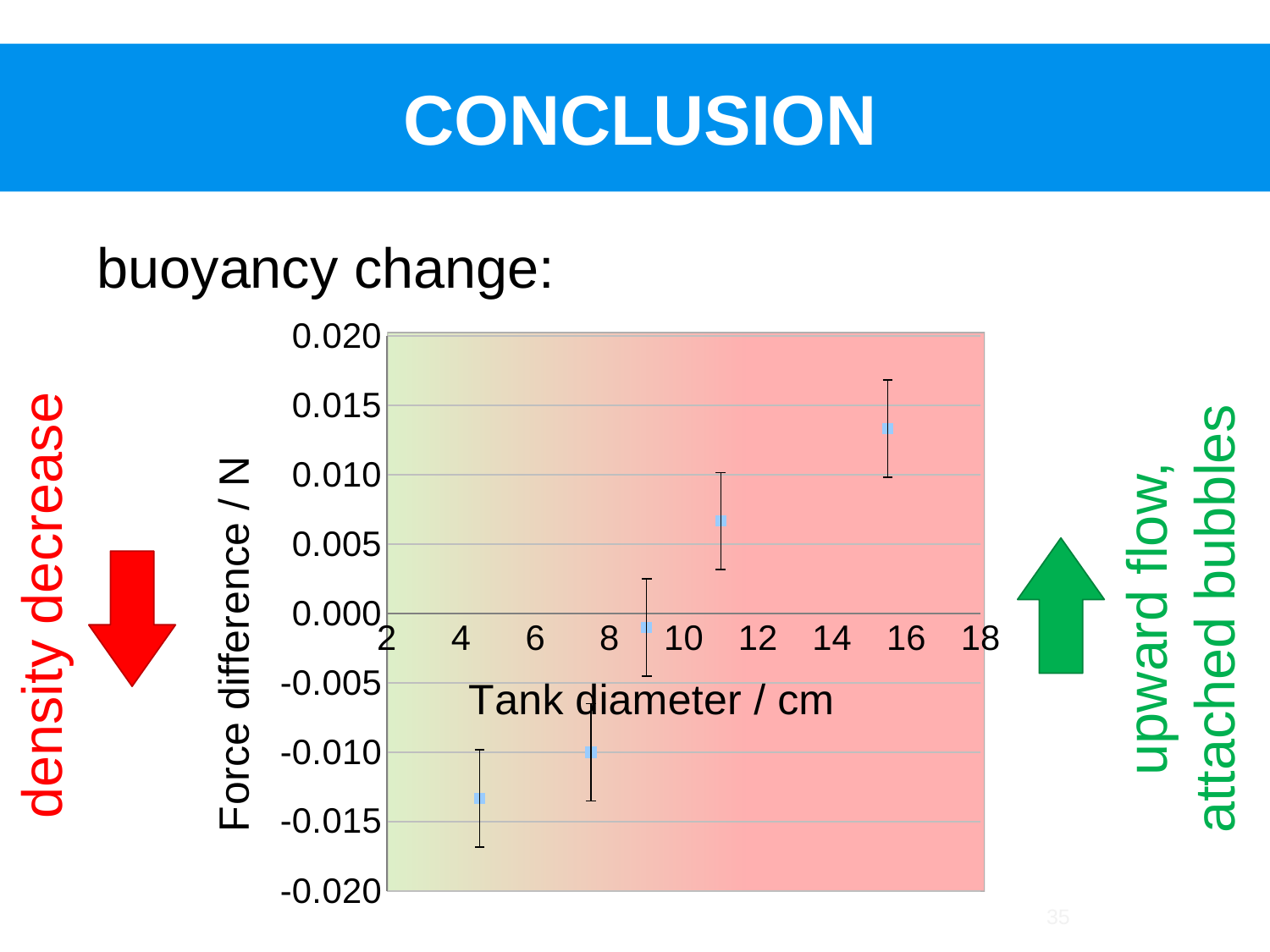
Is the force difference for the largest tank diameter (around 15–16 cm) greater or less than 0.010 N? greater Is the force difference for the smallest tank diameter (around 4–5 cm) greater or less than -0.010 N? less Is the force difference for the tank diameter of about 11 cm greater or less than 0.005 N? greater What is the label of the vertical axis of the chart? Force difference / N How many data points are plotted in the chart? 5 What is the label of the horizontal axis of the chart? Tank diameter / cm Does the lowest force difference occur at the smallest or the largest tank diameter? smallest Is the force difference at the largest tank diameter larger or smaller than at the smallest tank diameter? larger Does the force difference rise or fall as the tank diameter increases? rise Does the highest force difference occur at the smallest or the largest tank diameter? largest What kind of chart is shown on the slide? scatter chart